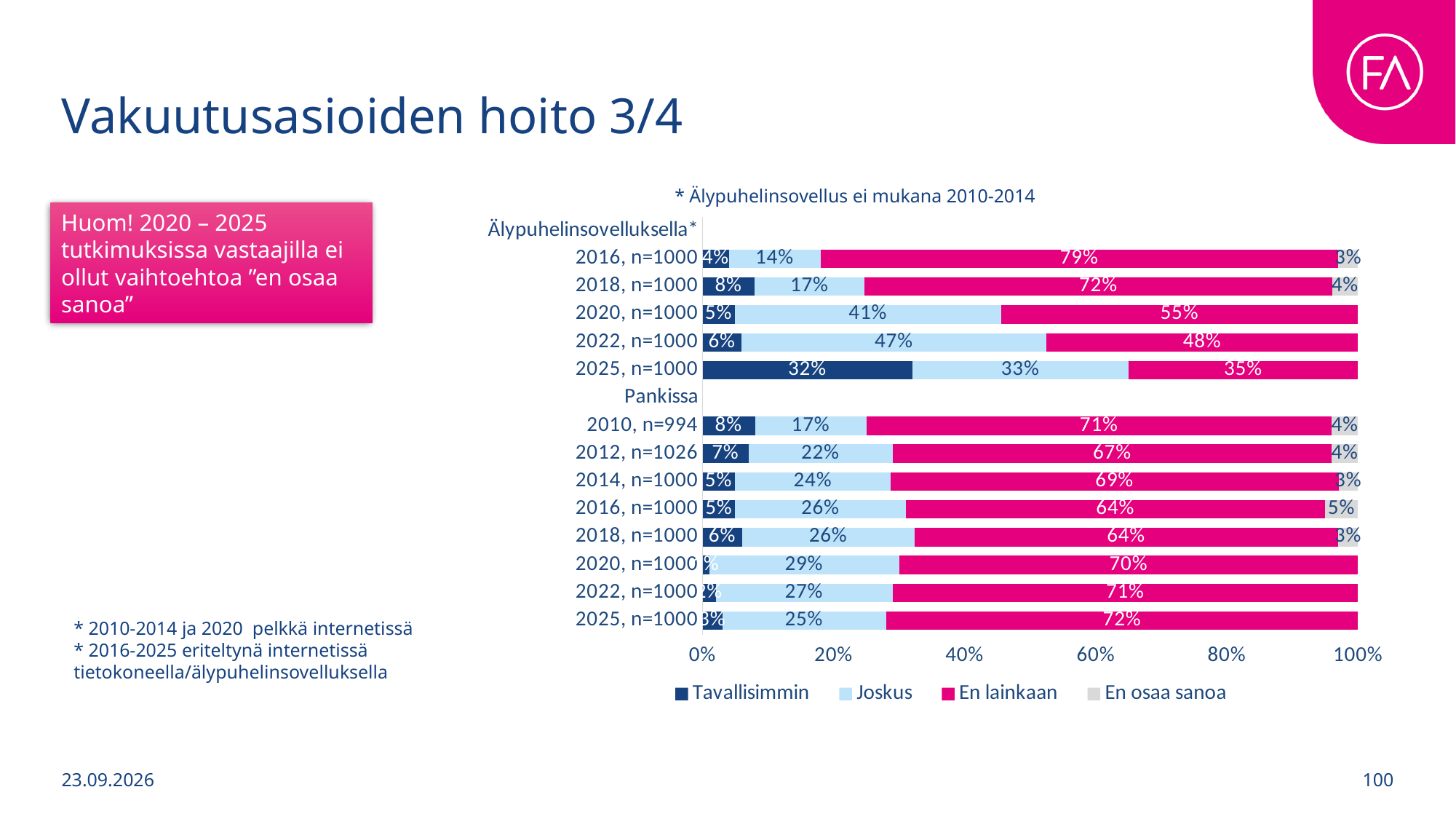
What is the 'Joskus' value for Pankissa 2020, n=1000? 29% What is the 'Tavallisimmin' value for Älypuhelinsovelluksella 2025, n=1000? 32% What is the 'En lainkaan' value for Älypuhelinsovelluksella 2016, n=1000? 79% Which has the larger 'En lainkaan' share: Pankissa 2012, n=1026 or Pankissa 2014, n=1000? Pankissa 2014, n=1000 What is the 'En osaa sanoa' value for Pankissa 2016, n=1000? 5% What is the difference in the 'Joskus' share between Älypuhelinsovelluksella 2022 and Älypuhelinsovelluksella 2016? 33 percentage points Which legend entry is shown in pink/magenta? En lainkaan How many series does the chart legend list? 4 Does the 'En lainkaan' share for Älypuhelinsovelluksella rise or fall from 2016 to 2025? Fall What kind of chart is shown on the slide? Stacked bar chart How many bars (survey rows) are plotted in the chart? 13 Among the Älypuhelinsovelluksella bars, which year has the highest 'Tavallisimmin' share? 2025, n=1000